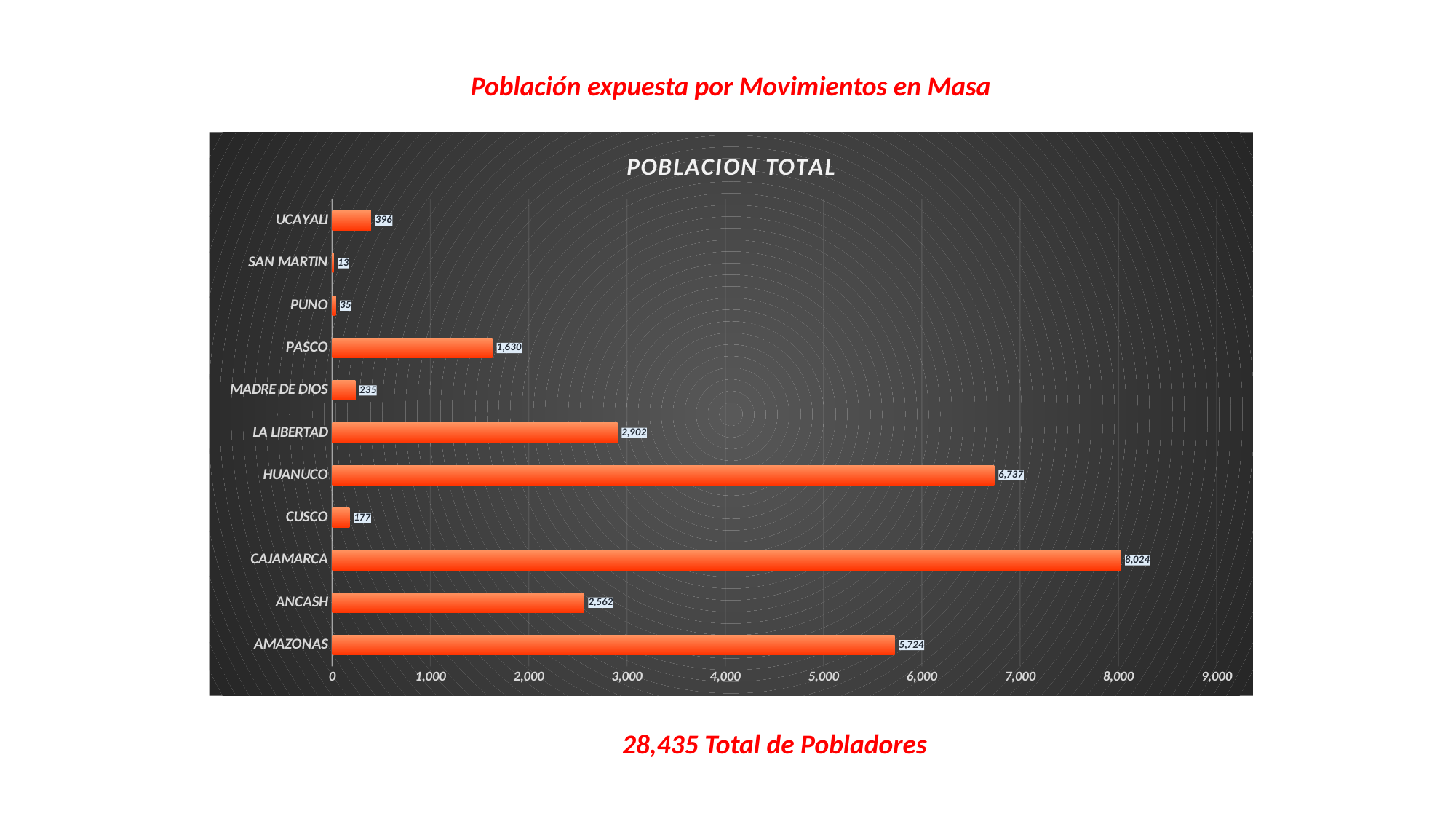
How many categories are shown in the chart? 11 Which category has the highest value? CAJAMARCA What is the difference between the values for CAJAMARCA and HUANUCO? 1,287 Which category has the lowest value? SAN MARTIN Is the value for AMAZONAS greater or less than 5,000? greater What is the value for HUANUCO? 6,737 What is the value for SAN MARTIN? 13 What kind of chart is shown on the slide? bar chart What is the value for PASCO? 1,630 Which is larger, the value for LA LIBERTAD or the value for ANCASH? LA LIBERTAD What is the title of the chart? POBLACION TOTAL What is the value for CAJAMARCA? 8,024